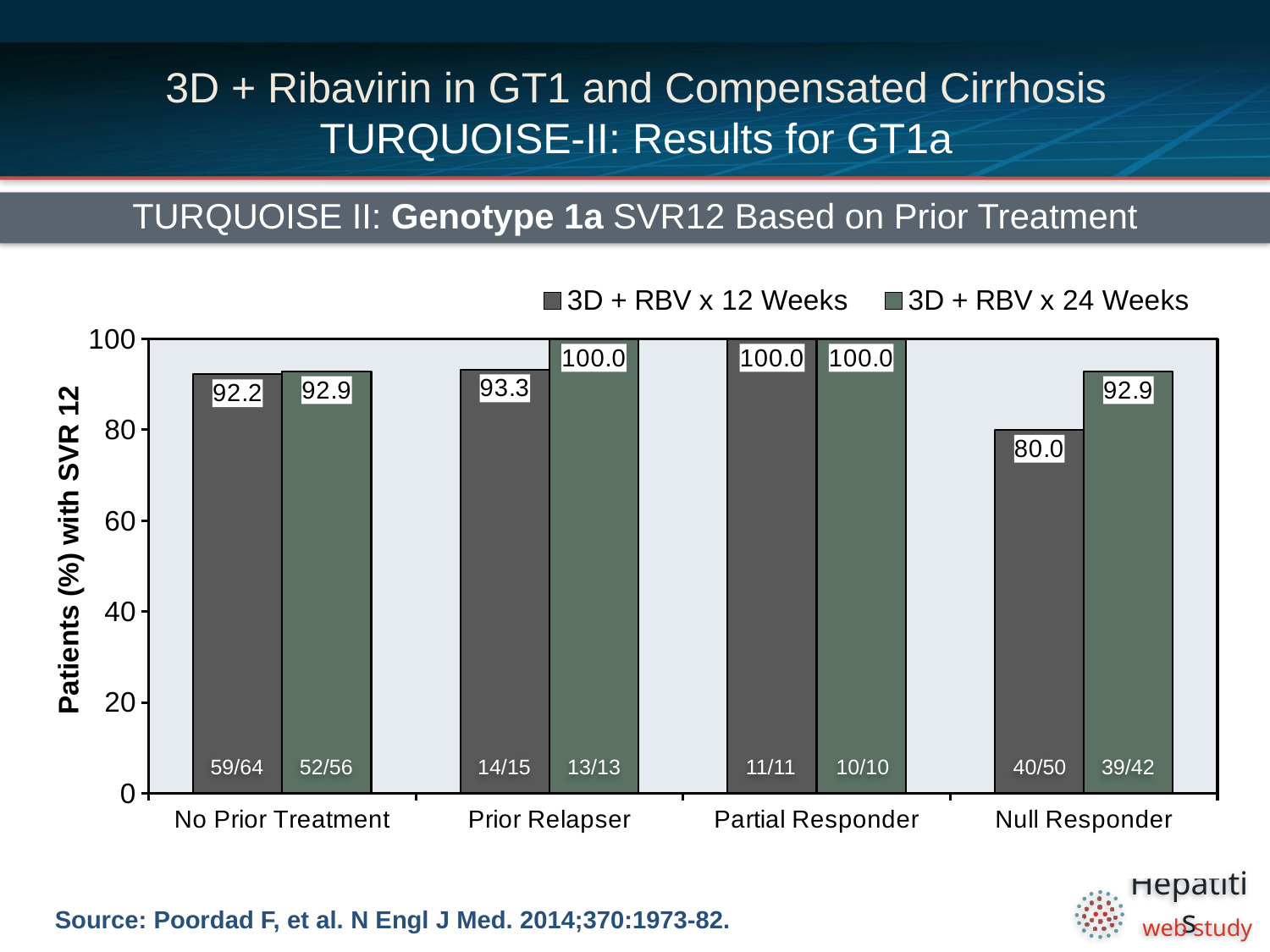
What is the difference between the 24-week and 12-week SVR12 rates in the Null Responder group? 12.9 How many prior treatment categories are shown on the x axis? 4 What kind of chart is shown on the slide? Bar chart Which category has the lowest value for the 3D + RBV x 24 Weeks series? No Prior Treatment and Null Responder (both 92.9) How many series does the legend list? 2 What is the SVR12 rate for the 3D + RBV x 12 Weeks series in the Prior Relapser group? 93.3 Is the value for 3D + RBV x 12 Weeks in the Null Responder group greater or less than 90? less Which category has the lowest value for the 3D + RBV x 12 Weeks series? Null Responder What is the label of the y axis? Patients (%) with SVR 12 What is the SVR12 rate for the 3D + RBV x 12 Weeks series in the No Prior Treatment group? 92.2 In the Prior Relapser group, which series has the higher SVR12 rate, 3D + RBV x 12 Weeks or 3D + RBV x 24 Weeks? 3D + RBV x 24 Weeks What is the SVR12 rate for the 3D + RBV x 24 Weeks series in the Null Responder group? 92.9